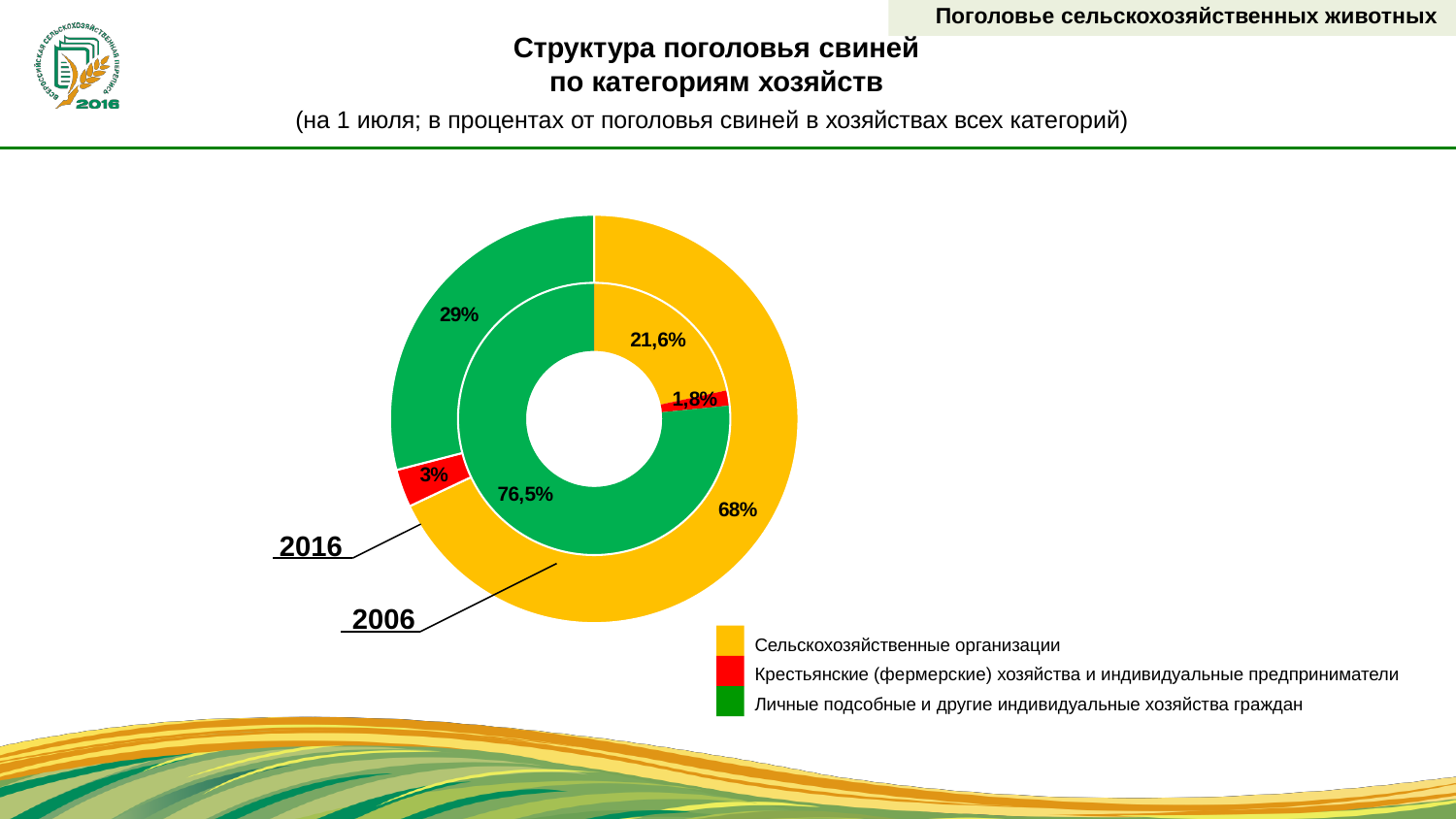
What is the share of Личные подсобные и другие индивидуальные хозяйства граждан in the inner ring of the chart? 76,5% What kind of chart is shown on the slide? Doughnut (pie) chart Which colour represents Крестьянские (фермерские) хозяйства и индивидуальные предприниматели in the chart? Red What is the difference between the shares of Сельскохозяйственные организации (68%) and Личные подсобные хозяйства (29%) in the outer ring? 39 percentage points What is the share of Сельскохозяйственные организации in the inner ring? 21,6% What is the difference between the share of Личные подсобные хозяйства in the inner ring (76,5%) and in the outer ring (29%)? 47,5 percentage points Which is larger: the share of Сельскохозяйственные организации in the outer ring or in the inner ring? Outer ring (68%) How many categories does the legend list? 3 Which category has the largest share in the outer ring? Сельскохозяйственные организации What is the share of Крестьянские (фермерские) хозяйства и индивидуальные предприниматели in the outer ring? 3% What is the share of Сельскохозяйственные организации in the outer ring of the chart? 68% Which category has the smallest share in the inner ring? Крестьянские (фермерские) хозяйства и индивидуальные предприниматели